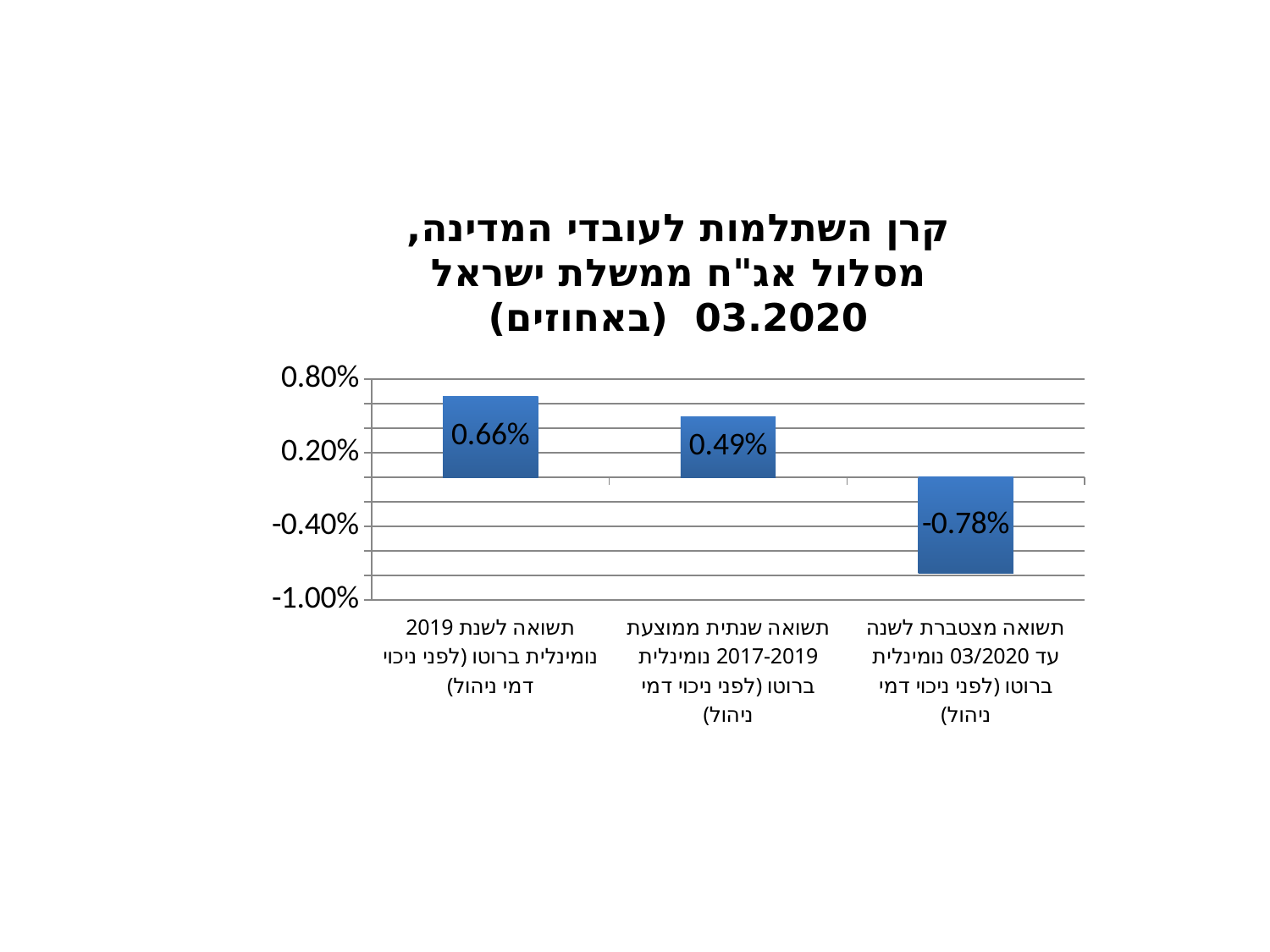
What is the value shown for the bar labelled "תשואה שנתית ממוצעת 2017-2019 נומינלית ברוטו (לפני ניכוי דמי ניהול)"? 0.49% What is the value shown for the bar labelled "תשואה לשנת 2019 נומינלית ברוטו (לפני ניכוי דמי ניהול)"? 0.66% How many of the plotted values are negative? 1 Which is larger: the return for 2019 or the average annual return for 2017-2019? The return for 2019 (0.66%) What type of chart is shown on the slide? Bar chart What is the difference between the 2019 return (0.66%) and the 2017-2019 average annual return (0.49%)? 0.17% What is the value shown for the bar labelled "תשואה מצטברת לשנה עד 03/2020 נומינלית ברוטו (לפני ניכוי דמי ניהול)"? -0.78% Which category has the highest value in the chart? תשואה לשנת 2019 נומינלית ברוטו (לפני ניכוי דמי ניהול) Is the value for the cumulative return to 03/2020 greater or less than -0.40%? less How many bars are plotted in the chart? 3 What is the lowest value shown on the vertical axis? -1.00% Which category has the lowest value in the chart? תשואה מצטברת לשנה עד 03/2020 נומינלית ברוטו (לפני ניכוי דמי ניהול)